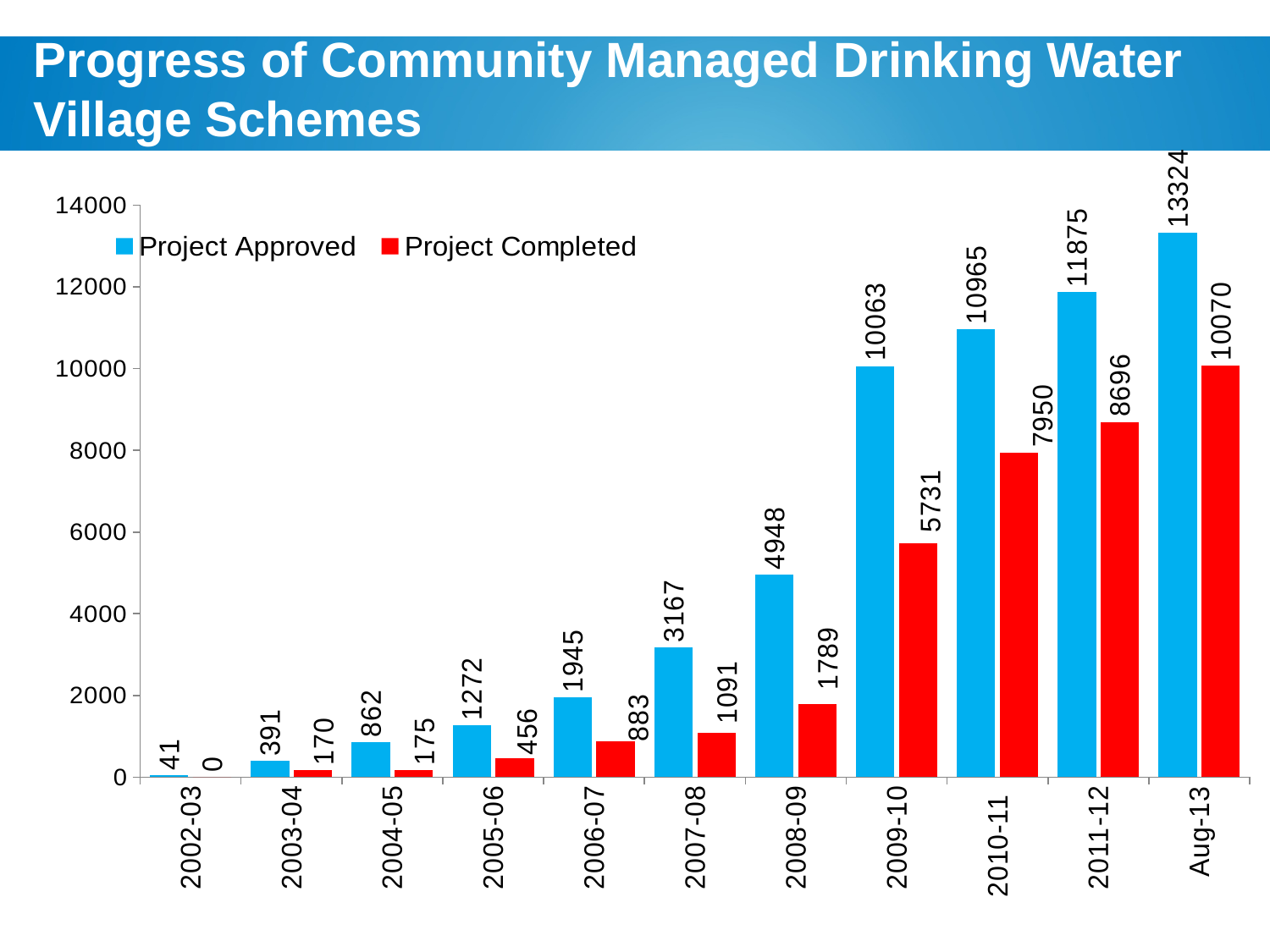
How many series does the legend list? 2 Which category has the lowest Project Completed value? 2002-03 Which category has the highest Project Approved value? Aug-13 How many categories are shown on the x axis? 11 What is the value of Project Completed for 2002-03? 0 Is the Project Approved value for 2010-11 greater or less than 10000? greater Which is larger: Project Completed for 2010-11 or Project Approved for 2008-09? Project Completed for 2010-11 Do the Project Approved values rise or fall from 2002-03 to Aug-13? rise What kind of chart is shown on the slide? bar chart What is the value of Project Approved for 2009-10? 10063 What is the value of Project Completed for 2011-12? 8696 What is the difference between Project Approved and Project Completed for Aug-13? 3254